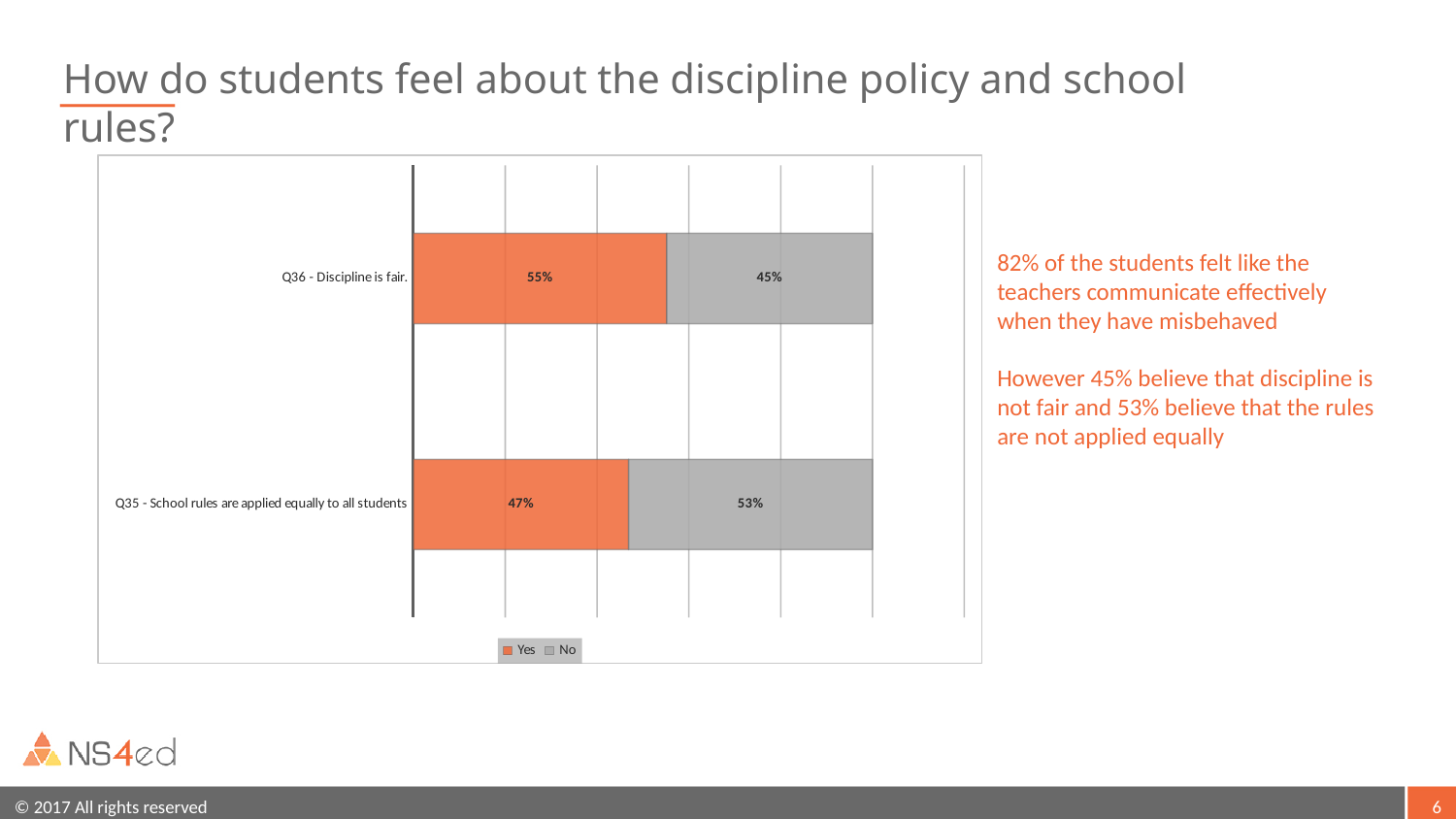
What percentage of students answered No to "Q36 - Discipline is fair."? 45% How many series does the legend list? 2 How many questions (categories) are shown in the chart? 2 What percentage of students answered Yes to "Q36 - Discipline is fair."? 55% Which colour represents the Yes responses in the chart? Orange What percentage of students answered No to "Q35 - School rules are applied equally to all students"? 53% Which question has the higher Yes percentage? Q36 - Discipline is fair. What is the difference between the Yes percentages for Q36 and Q35? 8% For Q35, is the Yes share or the No share larger? No Which question has the lower No percentage? Q36 - Discipline is fair. What type of chart is shown on the slide? Stacked bar chart What percentage of students answered Yes to "Q35 - School rules are applied equally to all students"? 47%